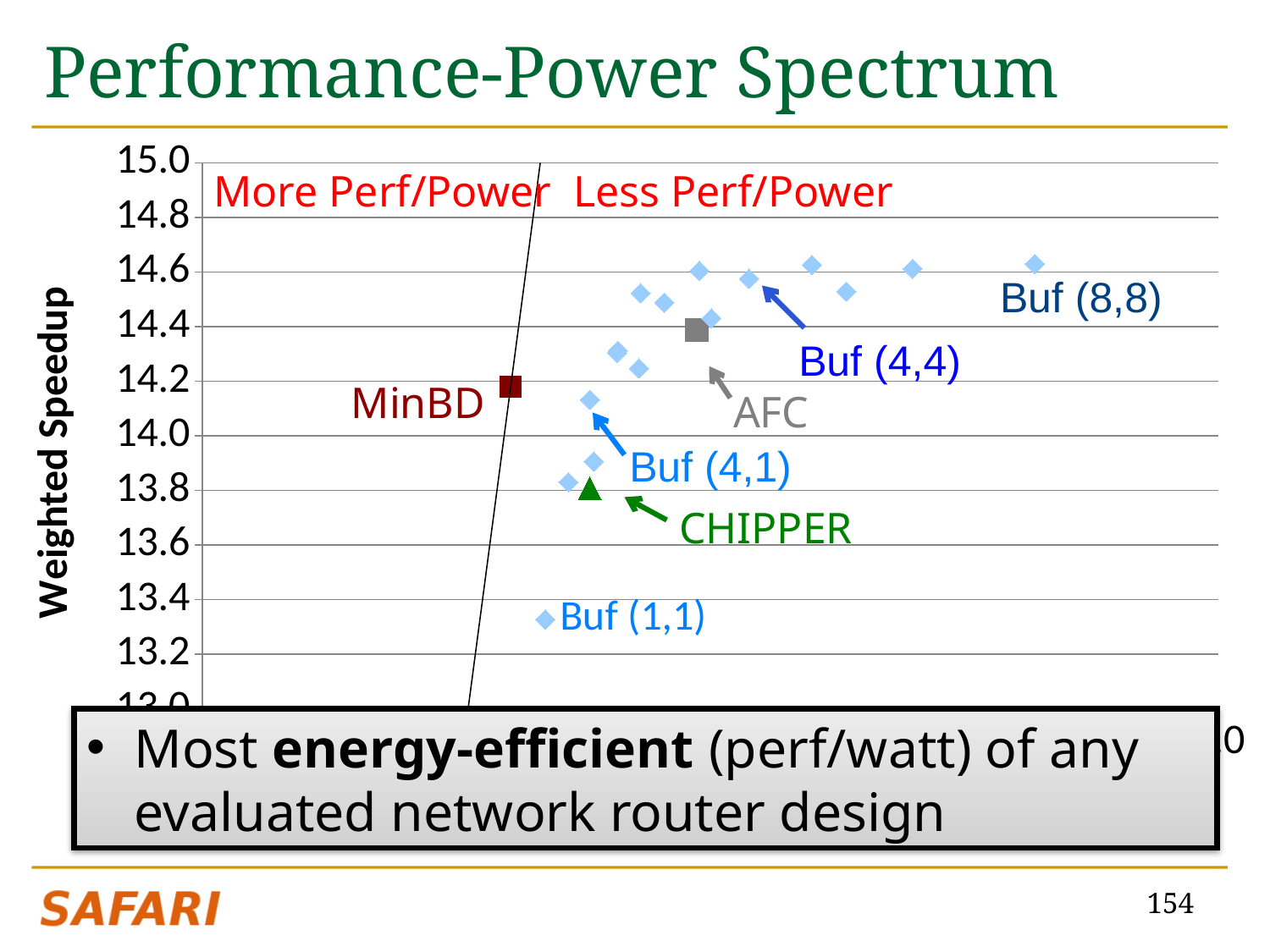
Is the weighted speedup for CHIPPER greater or less than 14.0? less Is the weighted speedup for MinBD greater or less than 14.0? greater Is the weighted speedup for AFC greater or less than 14.2? greater What is the title of the chart on the slide? Performance-Power Spectrum Which has a higher weighted speedup, MinBD or CHIPPER? MinBD What is the label of the vertical axis of the chart? Weighted Speedup What kind of chart is shown on the slide? scatter chart Which of the labeled router designs has the lowest weighted speedup? Buf (1,1) Which has a higher weighted speedup, Buf (8,8) or Buf (1,1)? Buf (8,8)